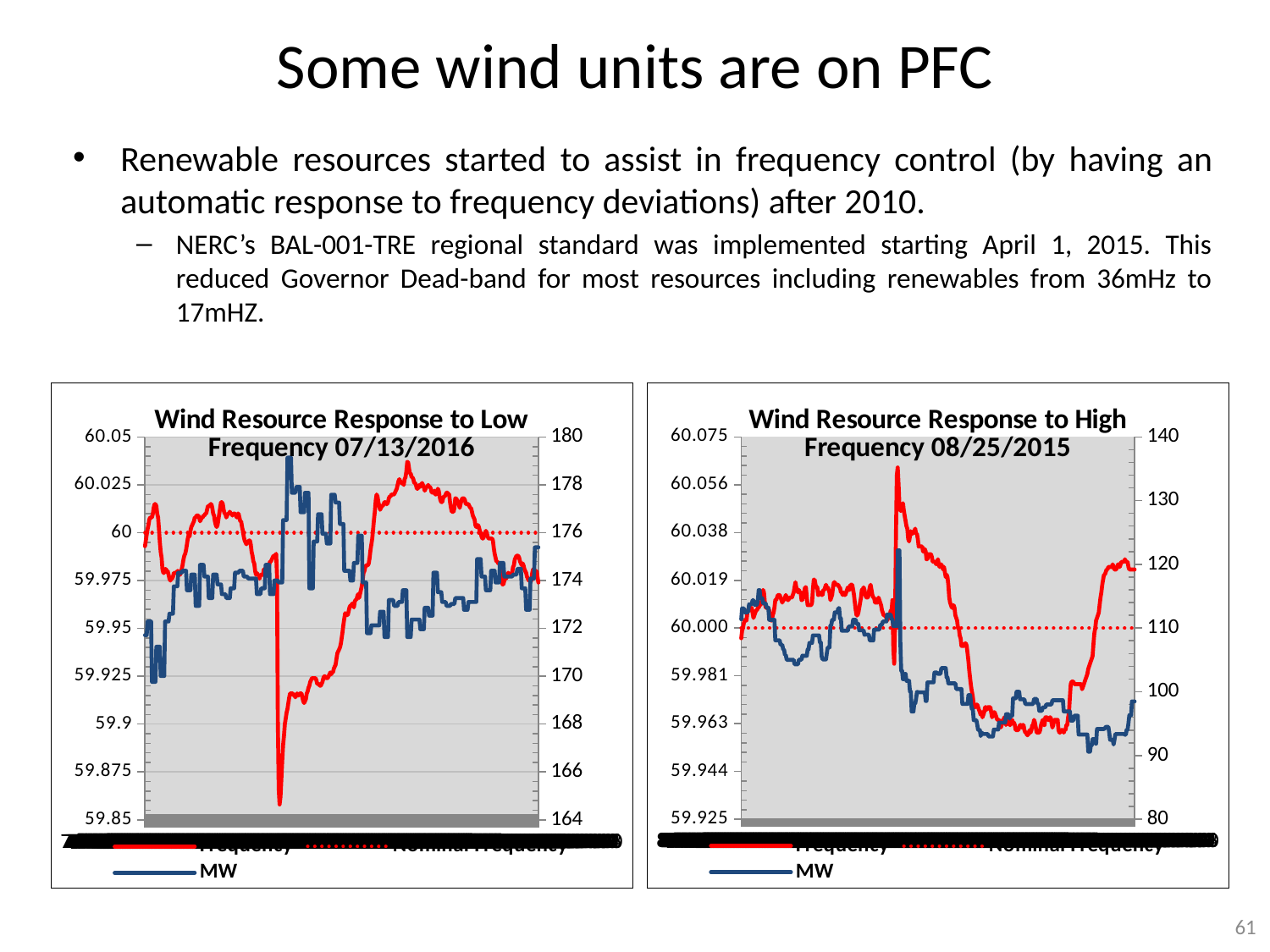
What colour is the Frequency series line in both charts? red How many series does the legend of the right chart list? 3 In the left chart, is the highest value of the MW series greater or less than 178? greater In the left chart, is the lowest value of the Frequency series greater or less than 59.9? less How many series does the legend of the left chart list? 3 In the right chart, is the highest value of the Frequency series greater or less than 60.038? greater In the left chart, at what frequency value does the dotted Nominal Frequency line sit? 60 What date appears in the title of the left chart? 07/13/2016 In the right chart, at what frequency value does the dotted Nominal Frequency line sit? 60.000 What kind of chart is the right chart, 'Wind Resource Response to High Frequency 08/25/2015'? line chart What kind of chart is the left chart, 'Wind Resource Response to Low Frequency 07/13/2016'? line chart